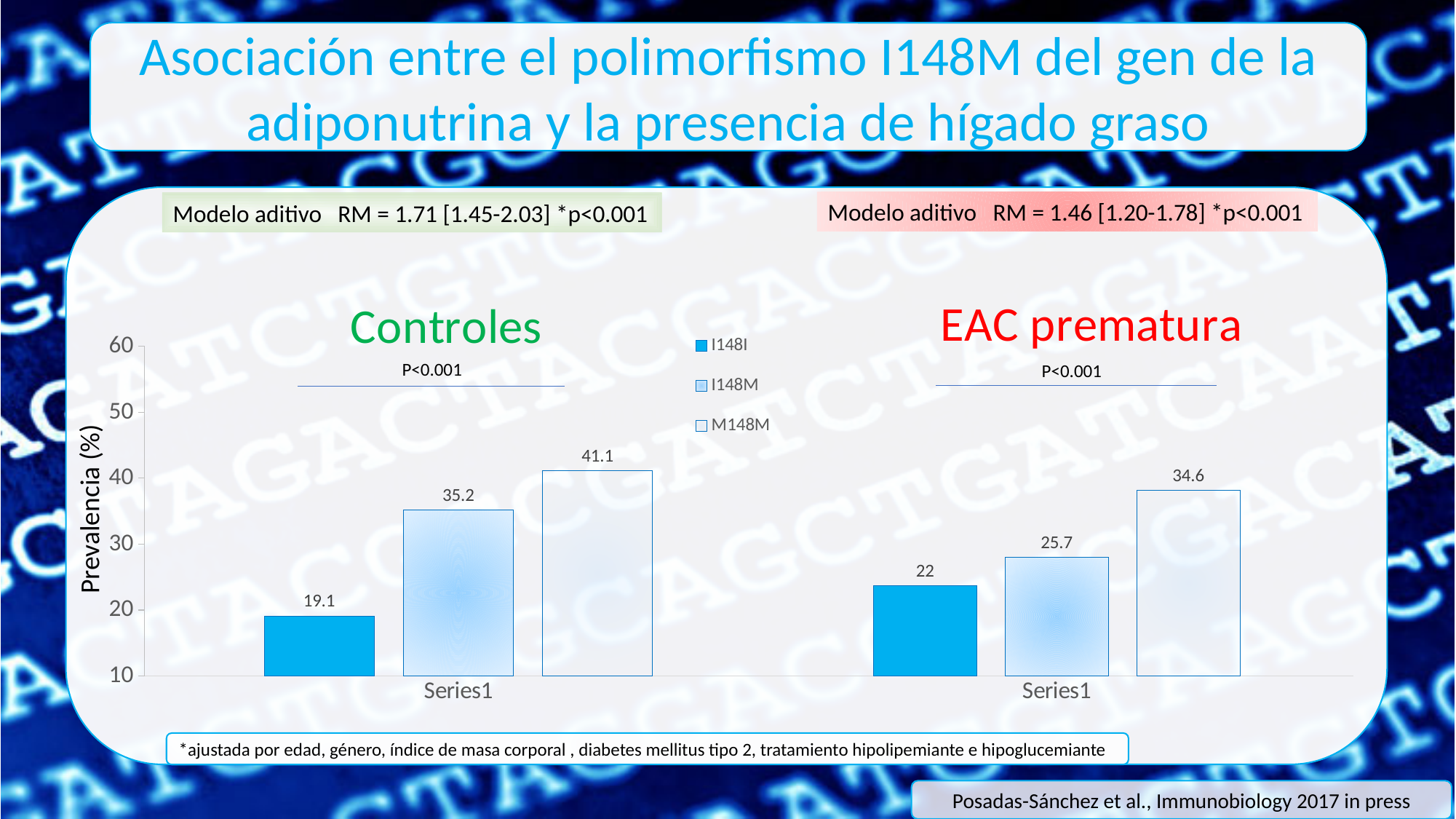
Which is larger: the M148M value in the Controles chart or the M148M value in the EAC prematura chart? Controles In the Controles chart, what is the prevalence value for the I148I genotype? 19.1 In the Controles chart, which genotype has the highest prevalence? M148M In the EAC prematura chart, what is the difference between the M148M and I148M prevalence values? 8.9 In the EAC prematura chart, which genotype has the lowest prevalence? I148I How many series does the legend list? 3 What type of chart is used for the Controles data? Bar chart What is the label of the vertical axis on the left chart? Prevalencia (%) In the EAC prematura chart, what is the prevalence value for the I148I genotype? 22 In the EAC prematura chart, what is the prevalence value for the I148M genotype? 25.7 In the Controles chart, what is the difference between the M148M and I148I prevalence values? 22 In the Controles chart, what is the prevalence value for the M148M genotype? 41.1